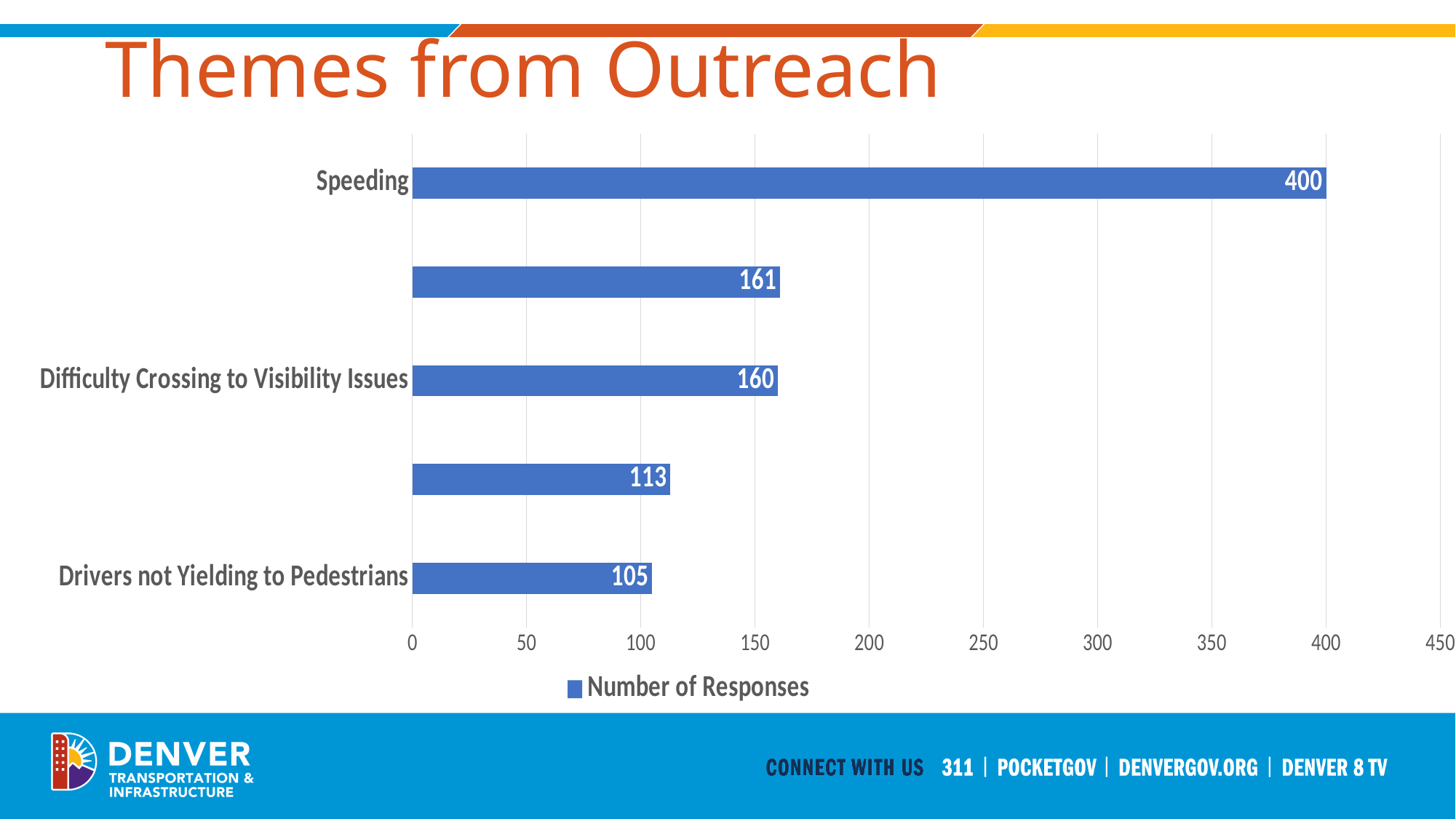
How many bars are plotted in the chart? 5 How many series does the legend list? 1 Which has more responses, Difficulty Crossing to Visibility Issues or Drivers not Yielding to Pedestrians? Difficulty Crossing to Visibility Issues What is the difference in responses between Speeding and Difficulty Crossing to Visibility Issues? 240 What kind of chart is shown on the slide? Bar chart What is the difference in responses between Speeding and Drivers not Yielding to Pedestrians? 295 What is the number of responses for Speeding? 400 Which theme has the highest number of responses? Speeding Is the value for Speeding greater or less than 350? greater Which theme has the lowest number of responses? Drivers not Yielding to Pedestrians What is the number of responses for Difficulty Crossing to Visibility Issues? 160 What is the number of responses for Drivers not Yielding to Pedestrians? 105